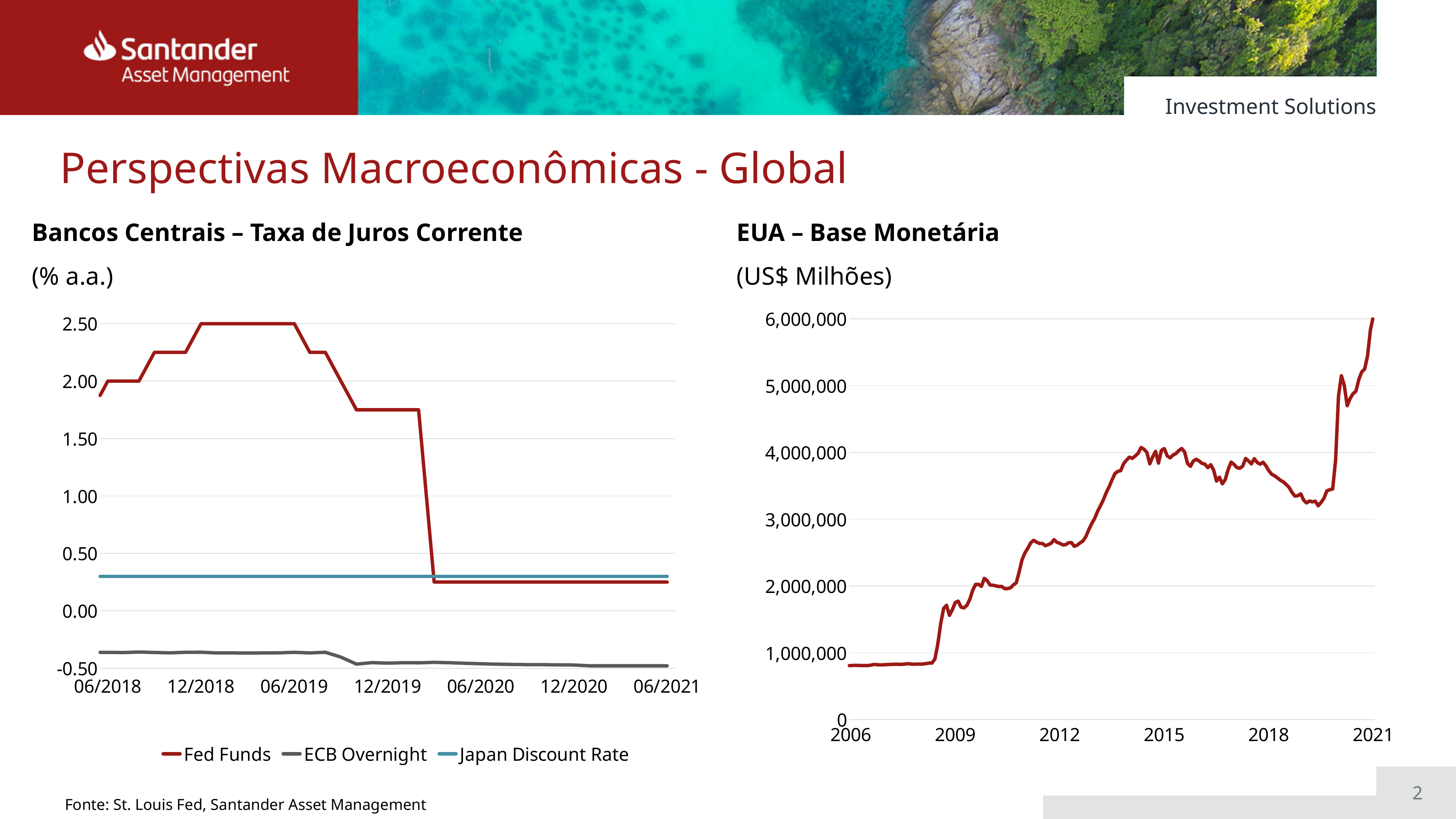
In the 'Bancos Centrais – Taxa de Juros Corrente' chart, how many series does the legend list? 3 In the 'Bancos Centrais – Taxa de Juros Corrente' chart, does the Fed Funds series rise or fall between 06/2019 and 06/2020? fall In the 'Bancos Centrais – Taxa de Juros Corrente' chart, is the ECB Overnight value at 06/2021 greater or less than 0.00? less What kind of chart is the 'EUA – Base Monetária' chart on the right? line chart In the 'Bancos Centrais – Taxa de Juros Corrente' chart, is the Fed Funds value at 06/2021 greater or less than 0.50? less In the 'Bancos Centrais – Taxa de Juros Corrente' chart, which series has the lowest value at 06/2021? ECB Overnight In the 'Bancos Centrais – Taxa de Juros Corrente' chart, is the Fed Funds value at 06/2019 greater or less than 2.00? greater In the 'Bancos Centrais – Taxa de Juros Corrente' chart, which series has the highest value at 06/2021: Fed Funds or ECB Overnight? Fed Funds What unit is shown under the title of the 'EUA – Base Monetária' chart? US$ Milhões In the 'EUA – Base Monetária' chart, does the series overall rise or fall from 2006 to 2021? rise